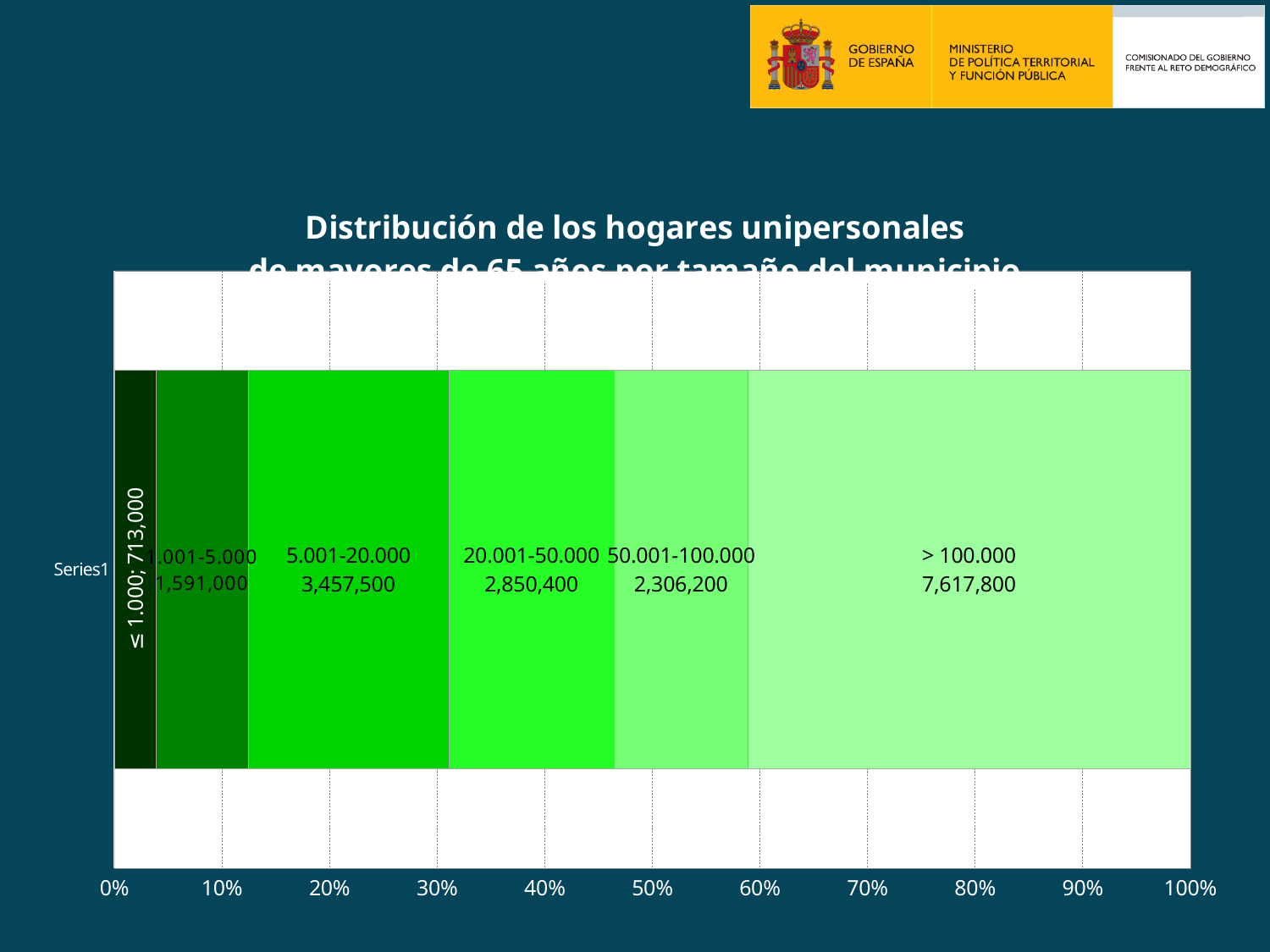
How many municipality size segments make up the bar? 6 Which municipality size category has the highest value? > 100.000 Which municipality size category has the lowest value? ≤ 1.000 Which is larger, the value for "20.001-50.000" or the value for "50.001-100.000"? 20.001-50.000 What is the difference between the values for "> 100.000" and "5.001-20.000"? 4,160,300 Is the share of the bar taken by the "> 100.000" segment greater or less than 30%? greater What is the value for the "5.001-20.000" segment? 3,457,500 What is the value for the "50.001-100.000" segment? 2,306,200 What is the value for the "≤ 1.000" segment? 713,000 What kind of chart is shown on the slide? bar chart What is the value for the "> 100.000" segment? 7,617,800 What is the value for the "20.001-50.000" segment? 2,850,400